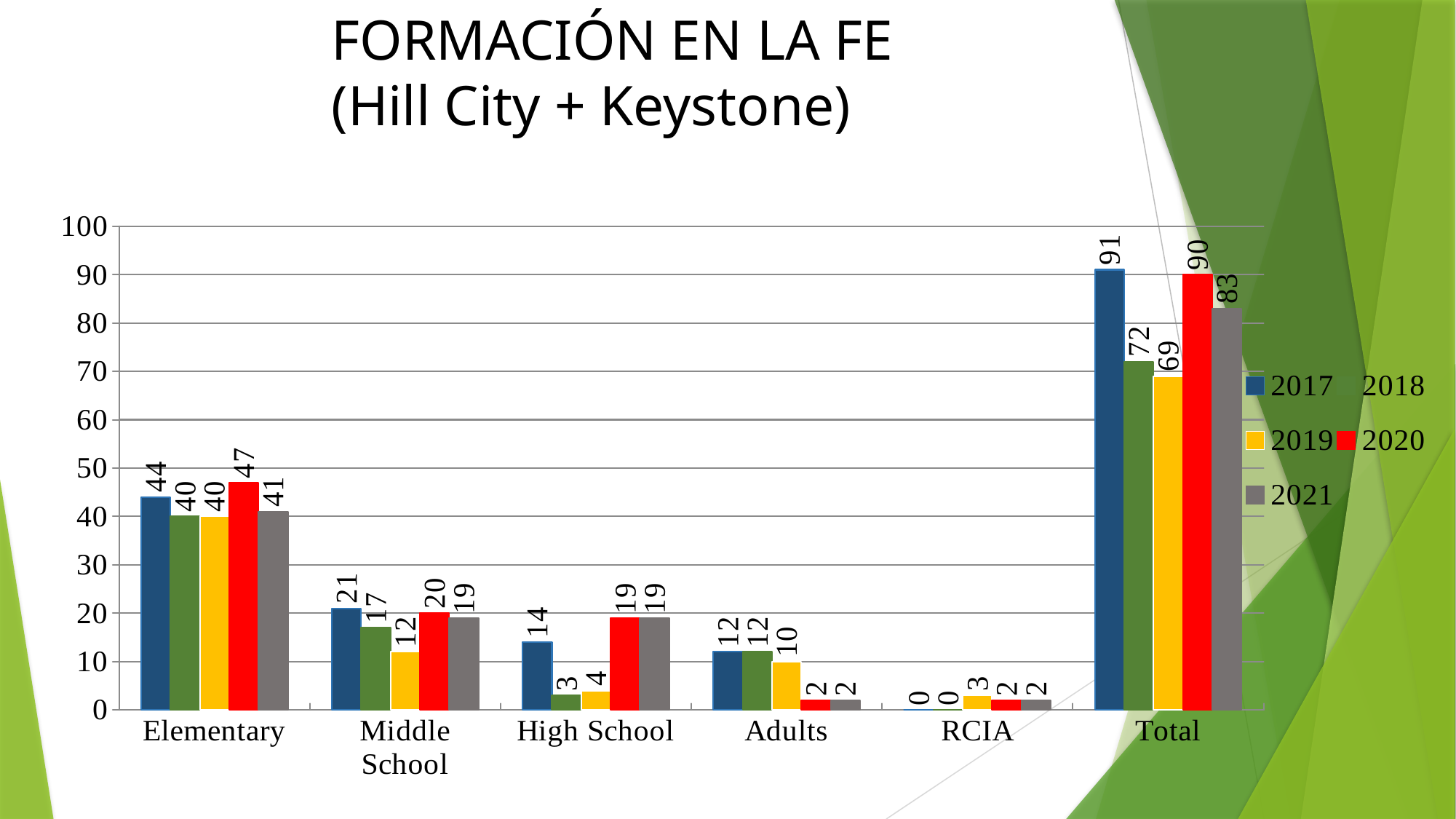
What is the difference between the Total values for 2017 and 2019? 22 What is the Total value for 2021? 83 How many series does the legend list? 5 What is the difference between the Elementary values for 2020 and 2018? 7 What is the value for High School in 2018? 3 Which year has the highest Total value? 2017 Which is larger, the Adults value for 2019 or the Adults value for 2020? 2019 Which year has the lowest value for Middle School? 2019 What kind of chart is shown on the slide? bar chart Which colour represents the 2020 series in the legend? red How many categories are shown on the x axis? 6 What is the value for Elementary in 2020? 47